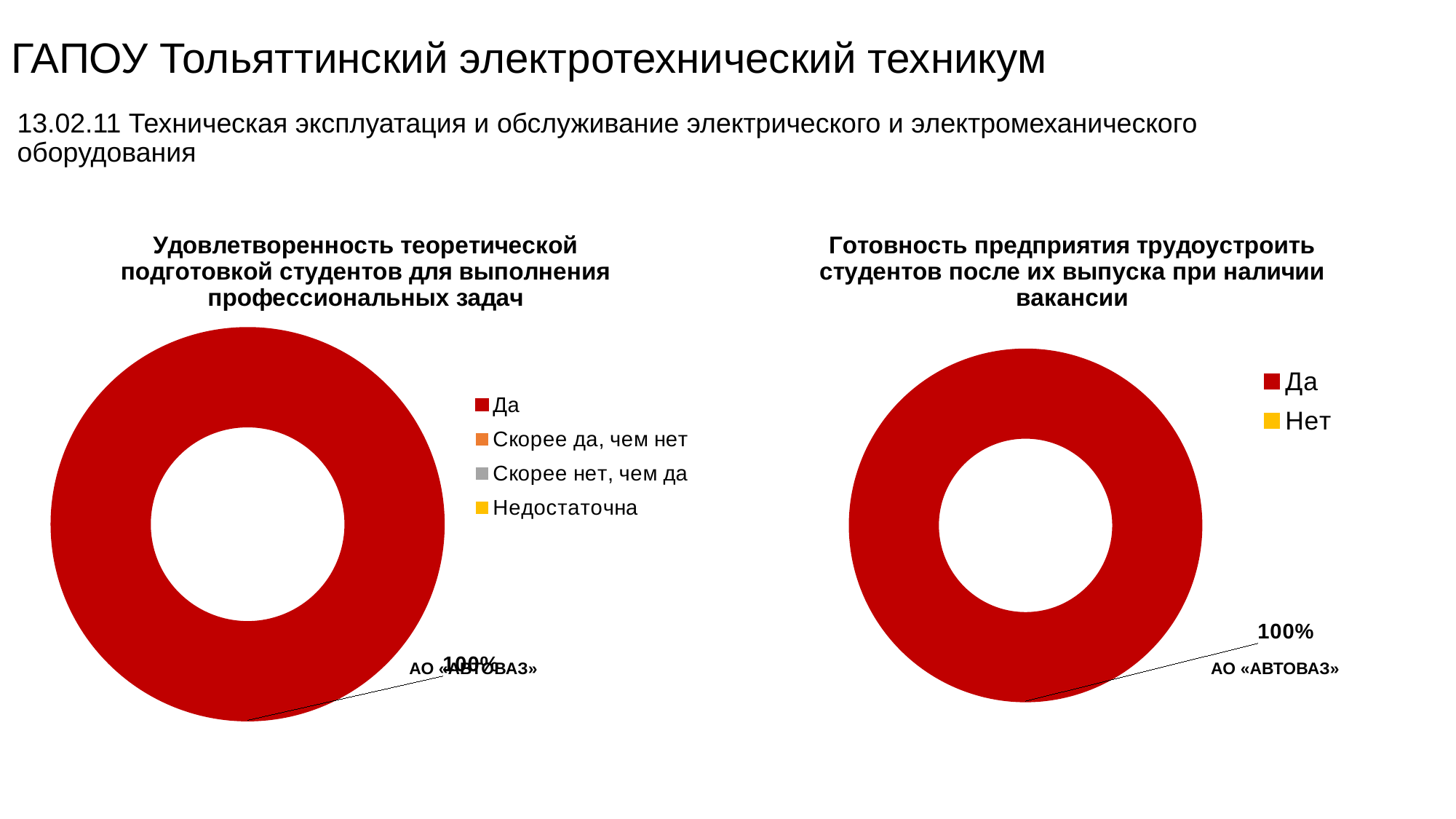
In the left chart ("Удовлетворенность теоретической подготовкой..."), which legend category fills the entire ring? Да How many visible slices does the left chart ("Удовлетворенность теоретической подготовкой...") have? 1 In the right chart ("Готовность предприятия трудоустроить студентов..."), what share of the ring does the "Да" category take? 100% How many entries does the legend of the left chart ("Удовлетворенность теоретической подготовкой...") list? 4 What are the legend entries of the right chart ("Готовность предприятия трудоустроить студентов...")? Да, Нет In the right chart ("Готовность предприятия трудоустроить студентов..."), what percentage is shown for the data label next to АО «АВТОВАЗ»? 100% What kind of chart is the left chart, titled "Удовлетворенность теоретической подготовкой студентов для выполнения профессиональных задач"? Doughnut (pie) chart In the left chart ("Удовлетворенность теоретической подготовкой..."), what percentage is shown for the data label next to АО «АВТОВАЗ»? 100% What kind of chart is the right chart, titled "Готовность предприятия трудоустроить студентов после их выпуска при наличии вакансии"? Doughnut (pie) chart In the left chart ("Удовлетворенность теоретической подготовкой..."), which legend entry is shown in yellow? Недостаточна How many entries does the legend of the right chart ("Готовность предприятия трудоустроить студентов...") list? 2 In the right chart ("Готовность предприятия трудоустроить студентов..."), which legend category fills the entire ring? Да